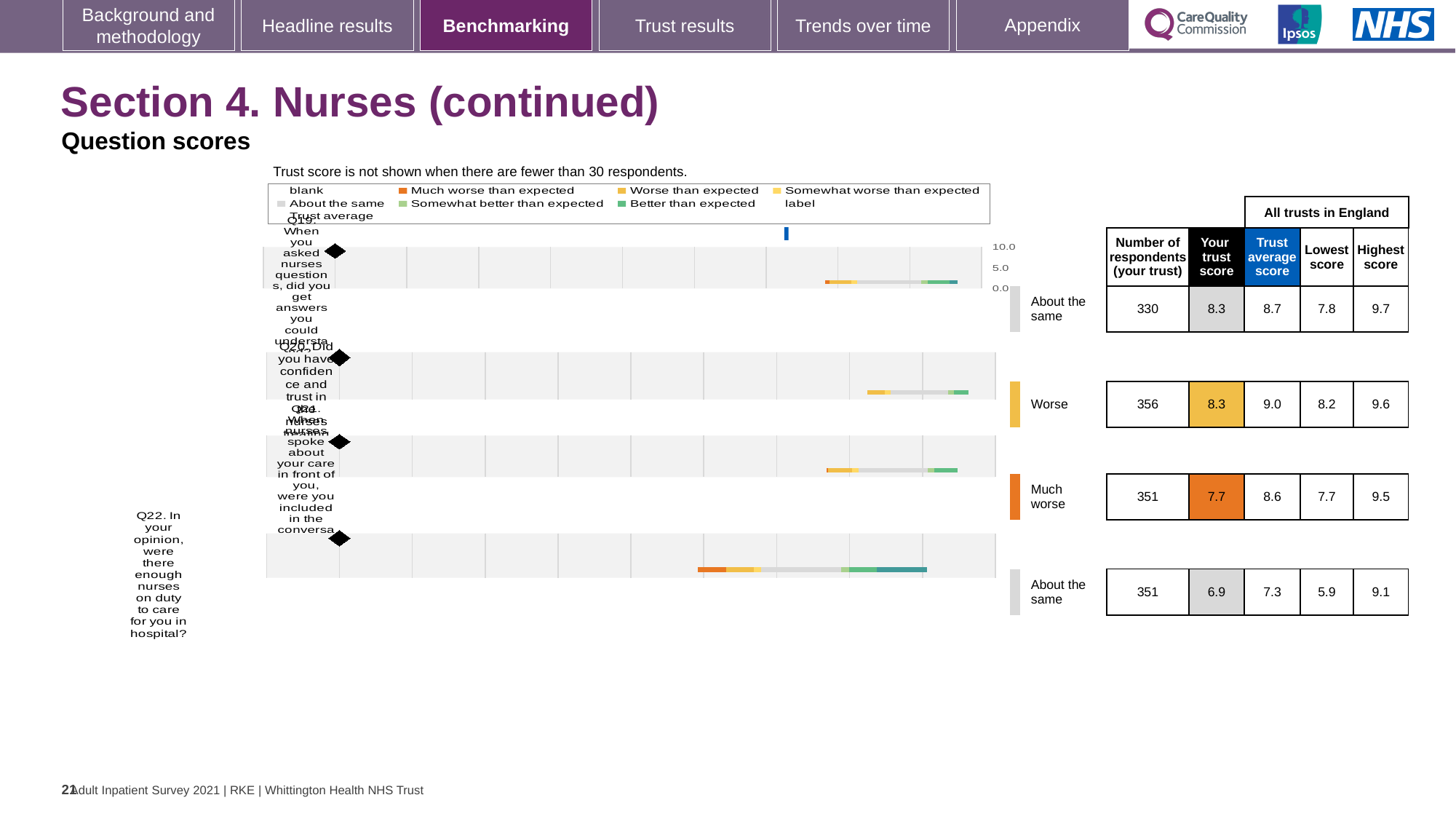
What is the maximum value shown on the chart's score axis? 10.0 Which benchmark category is shown for Q21 (nurses speaking about your care in front of you)? Much worse What is the trust average score for Q20 (confidence and trust in nurses)? 9.0 Which question has the lowest trust score? Q22 How many respondents answered Q20 at this trust? 356 What is the difference between the trust average score and this trust's score for Q21? 0.9 What is the highest score across all trusts in England for Q19? 9.7 How many survey questions (Q19 to Q22) are plotted in the chart? 4 What kind of chart is used to show the question scores on this slide? bar chart What is the trust score for Q22 (were there enough nurses on duty)? 6.9 What is the lowest score across all trusts in England for Q22? 5.9 Is this trust's score for Q21 larger or smaller than the trust average score for Q21? smaller